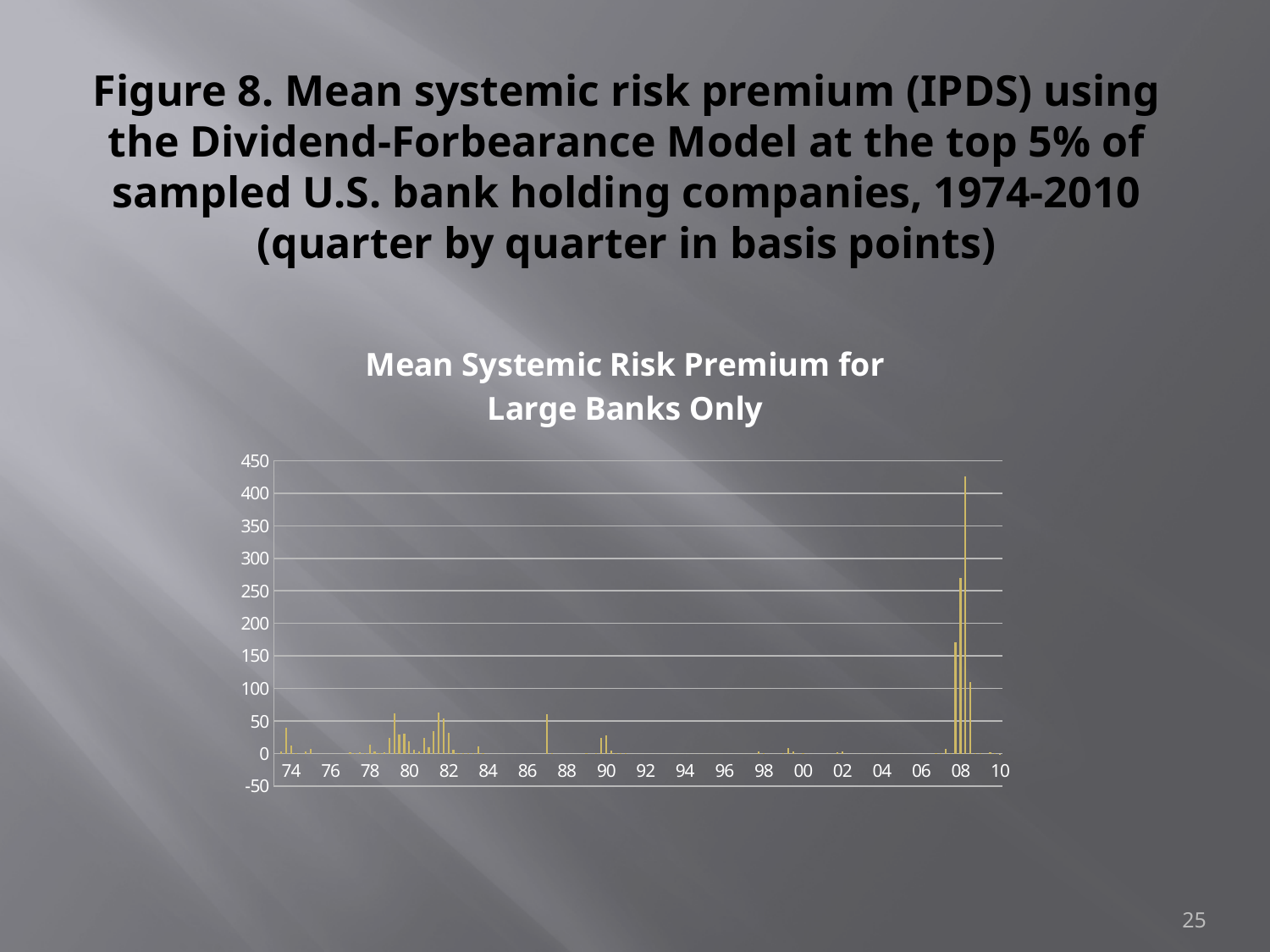
What is the highest value shown on the y axis? 450 What is the title of the chart on the slide? Mean Systemic Risk Premium for Large Banks Only Around which year label on the x axis does the tallest bar in the chart appear? 08 Which is larger: the tallest bar near 90 or the tallest bar near 08? The tallest bar near 08 Is the tallest bar in the chart greater or less than 400? greater Is the spike near the 87 mark (between 86 and 88) greater or less than 100? less Is the tallest bar near the 80 label on the x axis greater or less than 100? less Which is larger: the tallest bar near 08 or the tallest bar near 80? The tallest bar near 08 How many year labels are shown on the x axis? 19 What kind of chart is shown on the slide? Bar chart